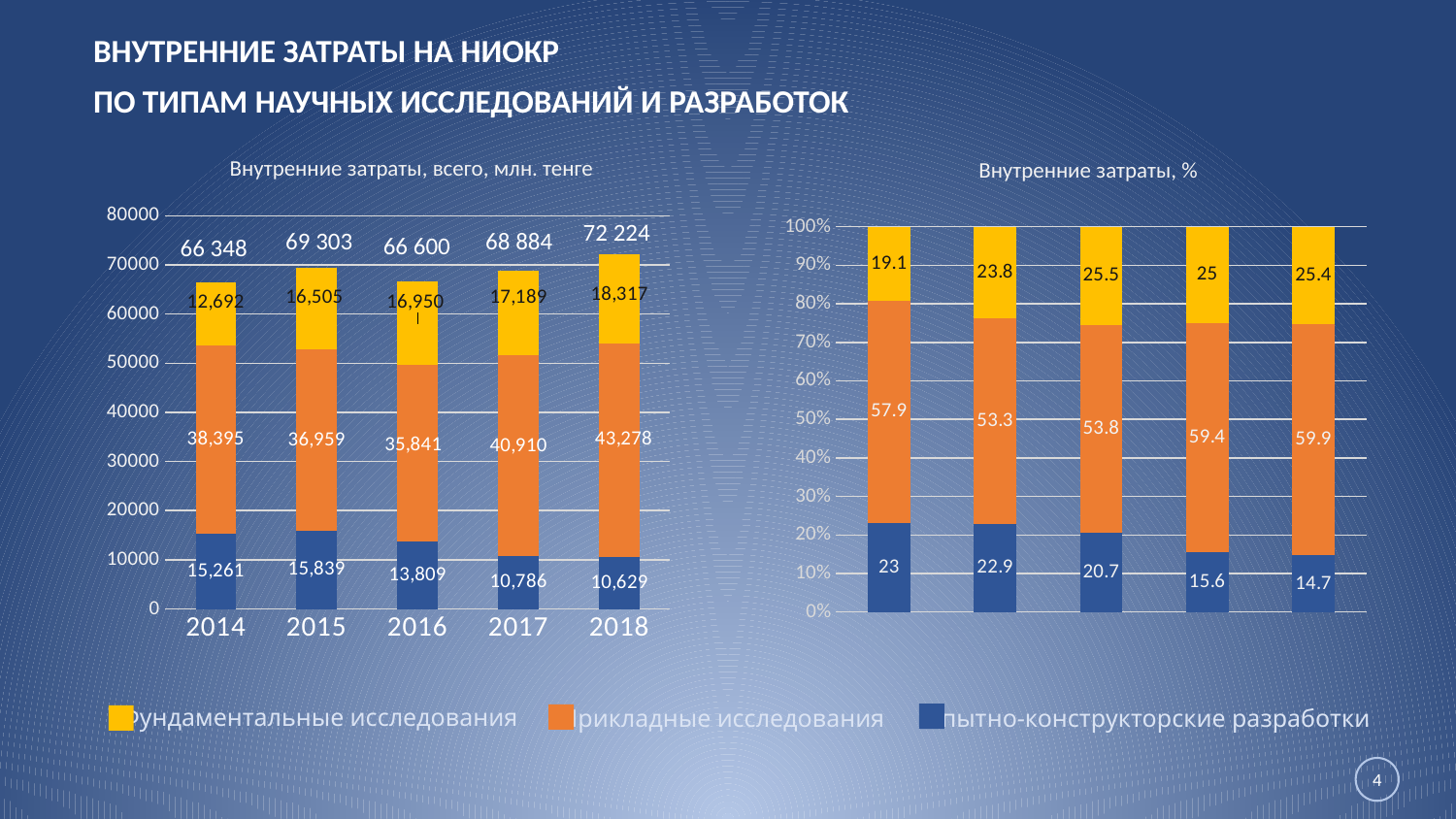
In the right chart 'Внутренние затраты, %', what is the value of the blue (Опытно-конструкторские разработки) segment in the last bar on the right? 14.7 In the left chart 'Внутренние затраты, всего, млн. тенге', by how much did Фундаментальные исследования increase from 2014 to 2018? 5,625 In the left chart 'Внутренние затраты, всего, млн. тенге', which year has the lowest value for Опытно-конструкторские разработки? 2018 In the right chart 'Внутренние затраты, %', what is the value of the yellow (Фундаментальные исследования) segment in the first bar from the left? 19.1 In the left chart 'Внутренние затраты, всего, млн. тенге', what is the total value shown above the 2018 bar? 72 224 How many series does the legend on the slide list? 3 What kind of chart is the right chart 'Внутренние затраты, %'? Stacked bar chart In the left chart 'Внутренние затраты, всего, млн. тенге', which year has the larger value for Прикладные исследования, 2015 or 2016? 2015 In the left chart 'Внутренние затраты, всего, млн. тенге', which year has the highest total? 2018 How many years are shown on the x axis of the left chart 'Внутренние затраты, всего, млн. тенге'? 5 In the left chart 'Внутренние затраты, всего, млн. тенге', is the total for 2016 greater or less than 70000? less In the left chart 'Внутренние затраты, всего, млн. тенге', what is the value for Прикладные исследования in 2017? 40,910